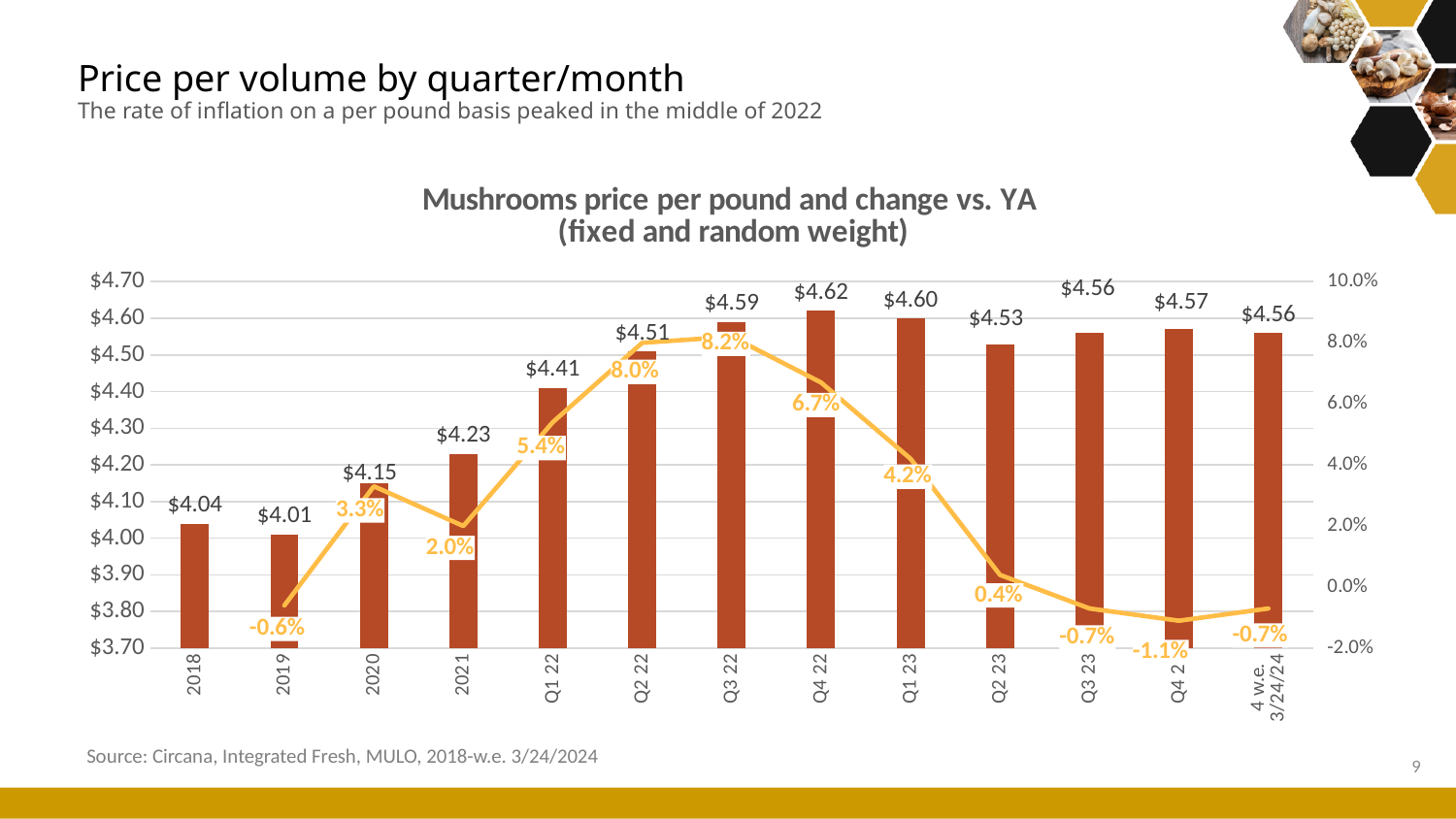
Does the price per pound rise or fall from 2018 to Q4 22? Rises What is the mushrooms price per pound for Q4 22? $4.62 Which period has the highest price per pound? Q4 22 What is the difference in price per pound between Q4 22 and 2018? $0.58 How many periods (bars) are shown on the chart? 13 Which has the higher price per pound, Q1 23 or Q2 23? Q1 23 What is the change vs. YA shown for Q3 22? 8.2% What is the price per pound for the 4 w.e. 3/24/24 period? $4.56 What is the change vs. YA shown for 2019? -0.6% What kind of chart is this? Combination bar and line chart Which period has the highest change vs. YA on the line? Q3 22 Which period has the lowest price per pound? 2019